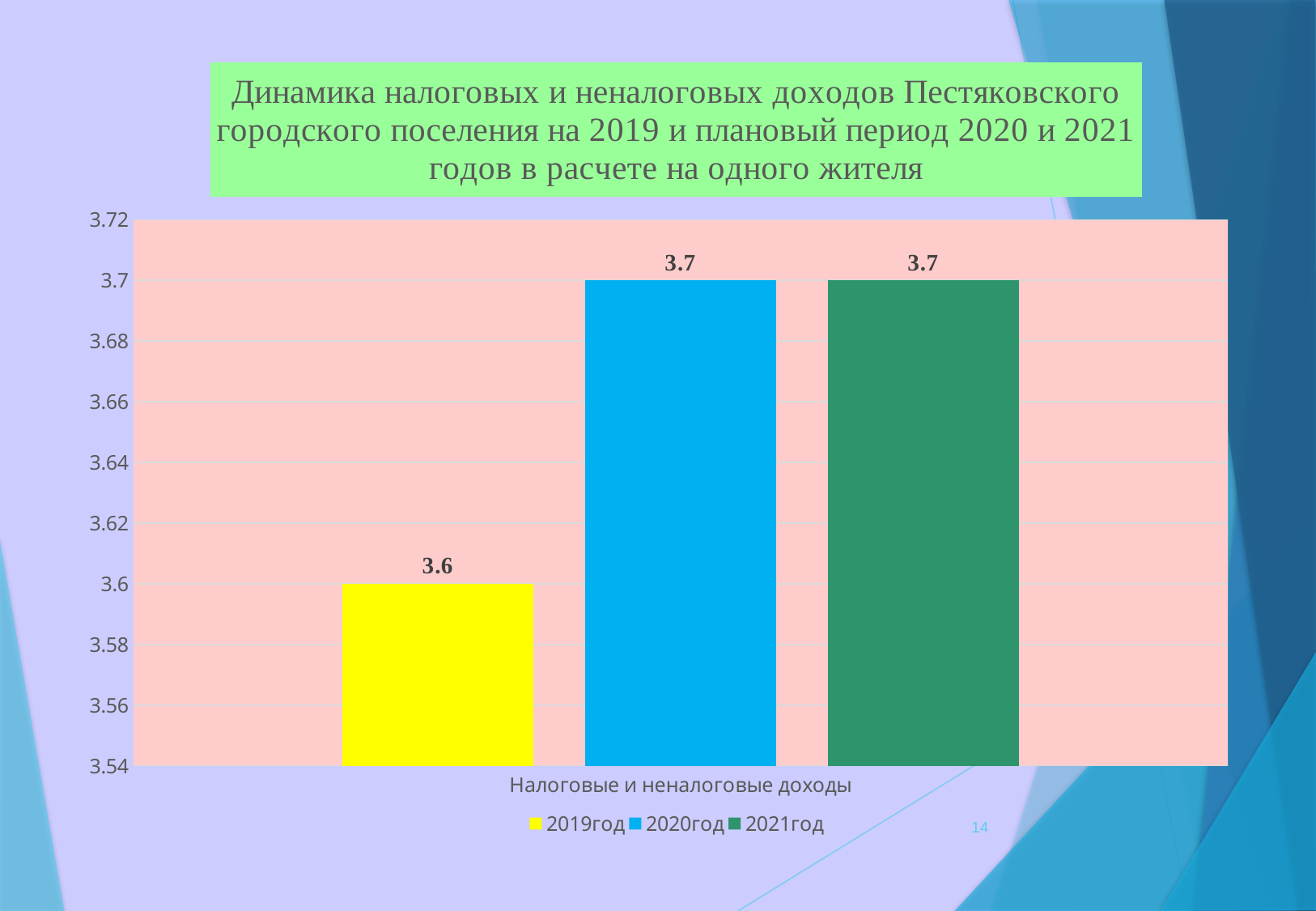
Is the value for 2020год greater or less than 3.68? greater What is the difference between the values for 2020год and 2019год? 0.1 What is the value for 2020год? 3.7 Which year has the lowest value? 2019год How many series does the legend list? 3 Is the value for 2019год greater or less than 3.62? less What is the category label shown on the x axis? Налоговые и неналоговые доходы What kind of chart is shown on the slide? bar chart What is the value for 2021год? 3.7 What is the value for 2019год? 3.6 What colour is the bar for 2021год? green Which is larger, the value for 2019год or the value for 2021год? 2021год